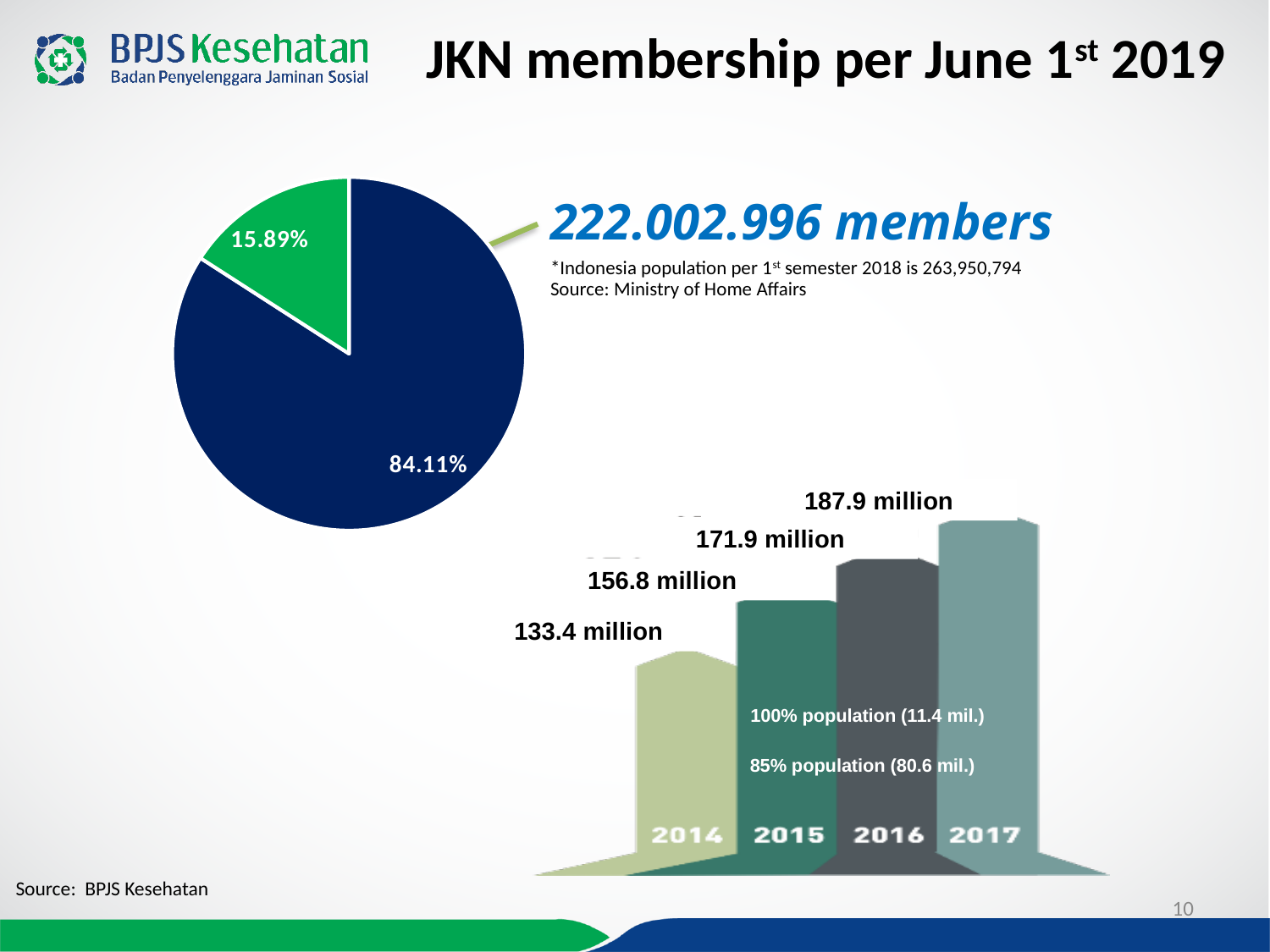
In the pie chart on the left, what share does the green slice represent? 15.89% In the bar chart at the bottom right, which year has the highest value? 2017 How many years are shown in the bar chart at the bottom right? 4 In the bar chart at the bottom right, which year has the lowest value? 2014 In the bar chart at the bottom right, what is the value for 2014? 133.4 million In the bar chart at the bottom right, what is the difference between the 2017 and 2014 values? 54.5 million In the bar chart at the bottom right, do the values rise or fall from 2014 to 2017? rise In the bar chart at the bottom right, what is the value for 2017? 187.9 million In the bar chart at the bottom right, what is the difference between the 2015 and 2014 values? 23.4 million In the bar chart at the bottom right, what is the value for 2016? 171.9 million In the pie chart on the left, what share does the larger (dark blue) slice represent? 84.11% What kind of chart is the chart on the left of the slide? pie chart